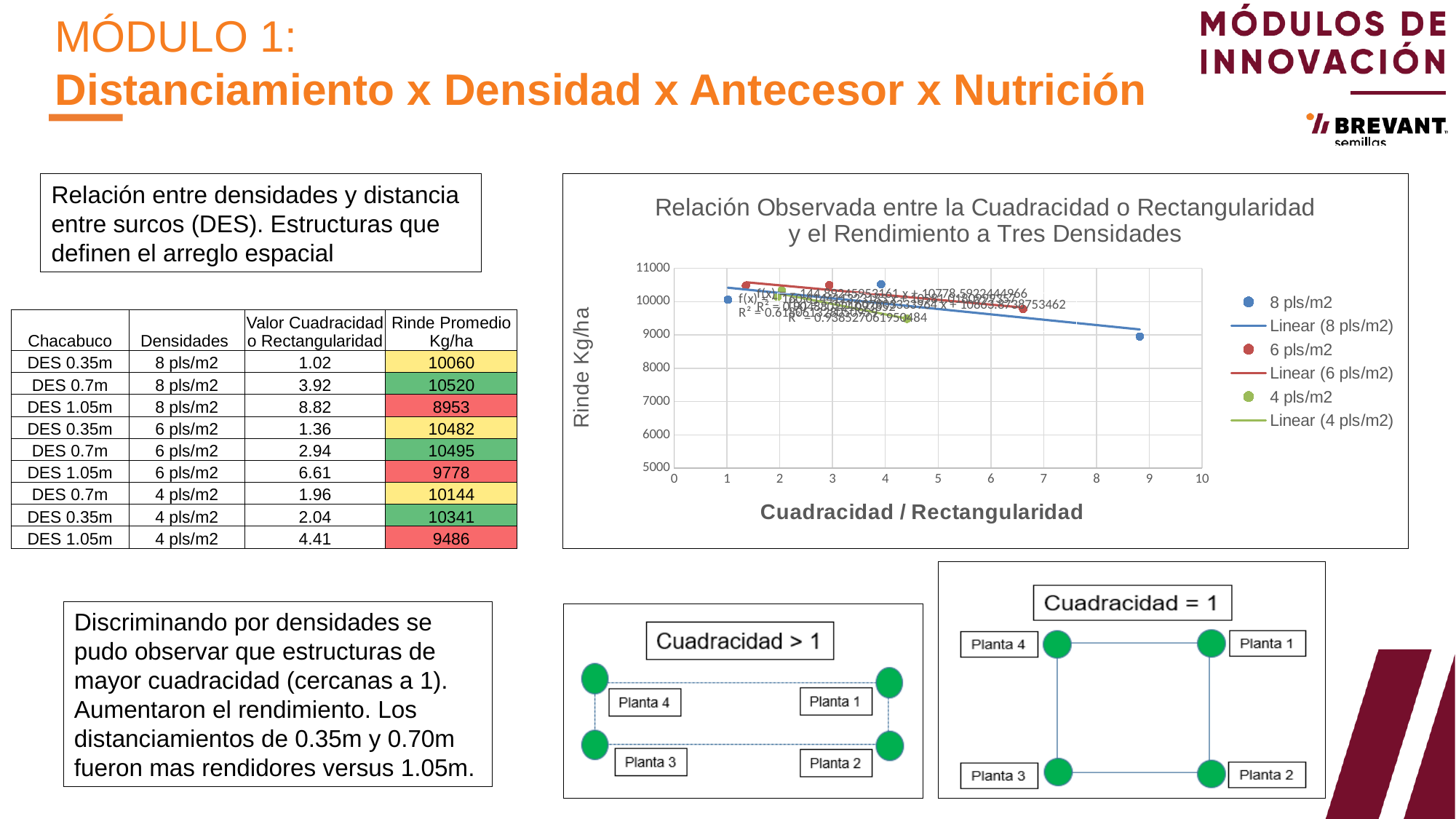
Does the linear trendline for 6 pls/m2 rise or fall along the x axis? Fall What is the title of the chart? Relación Observada entre la Cuadracidad o Rectangularidad y el Rendimiento a Tres Densidades What kind of chart is shown on the slide? Scatter chart How many data points are plotted in total across all three series? 9 Is the Rinde value for the 6 pls/m2 point near x = 6.6 greater or less than 10000? less How many data points are plotted for the 8 pls/m2 series? 3 What is the label of the x axis of the chart? Cuadracidad / Rectangularidad How many data point series (excluding trendlines) are plotted in the chart? 3 How many series does the chart legend list (including the linear trendlines)? 6 Is the Rinde value for the 8 pls/m2 point near x = 4 greater or less than 10000? greater Is the Rinde value for the 8 pls/m2 point near x = 9 greater or less than 10000? less Does the linear trendline for 8 pls/m2 rise or fall as Cuadracidad / Rectangularidad increases? Fall